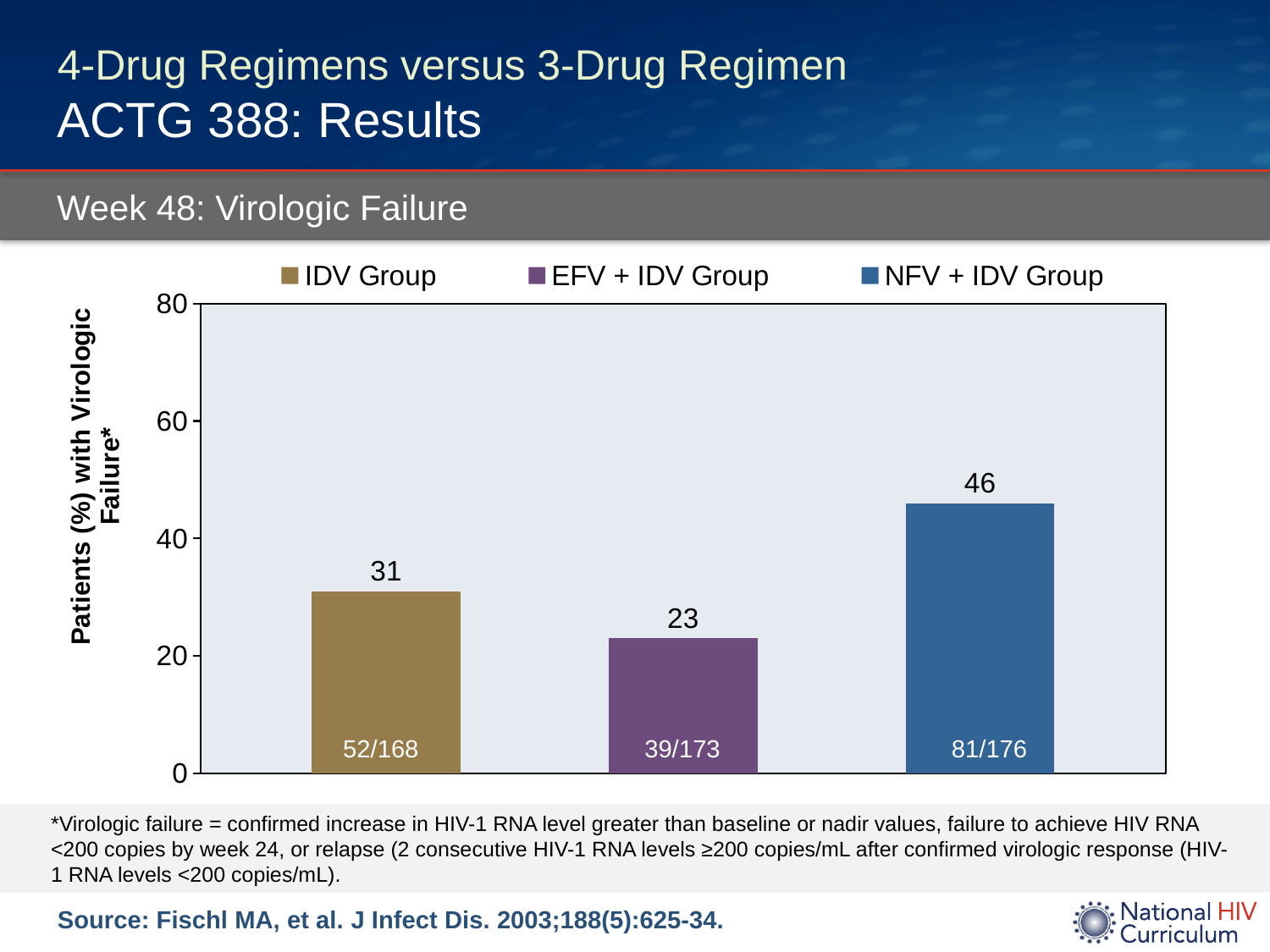
How many series does the legend list? 3 Which group had the highest percentage of patients with virologic failure? NFV + IDV Group What fraction is printed inside the bar for the NFV + IDV Group? 81/176 How many groups are shown in the chart? 3 What percentage of patients in the EFV + IDV Group had virologic failure at week 48? 23 What percentage of patients in the IDV Group had virologic failure at week 48? 31 Which group had a higher percentage of virologic failure, the IDV Group or the EFV + IDV Group? IDV Group Which group had the lowest percentage of patients with virologic failure? EFV + IDV Group What is the difference in virologic failure percentage between the NFV + IDV Group and the EFV + IDV Group? 23 What type of chart is shown on the slide? Bar chart What fraction is printed inside the bar for the EFV + IDV Group? 39/173 What percentage of patients in the NFV + IDV Group had virologic failure at week 48? 46